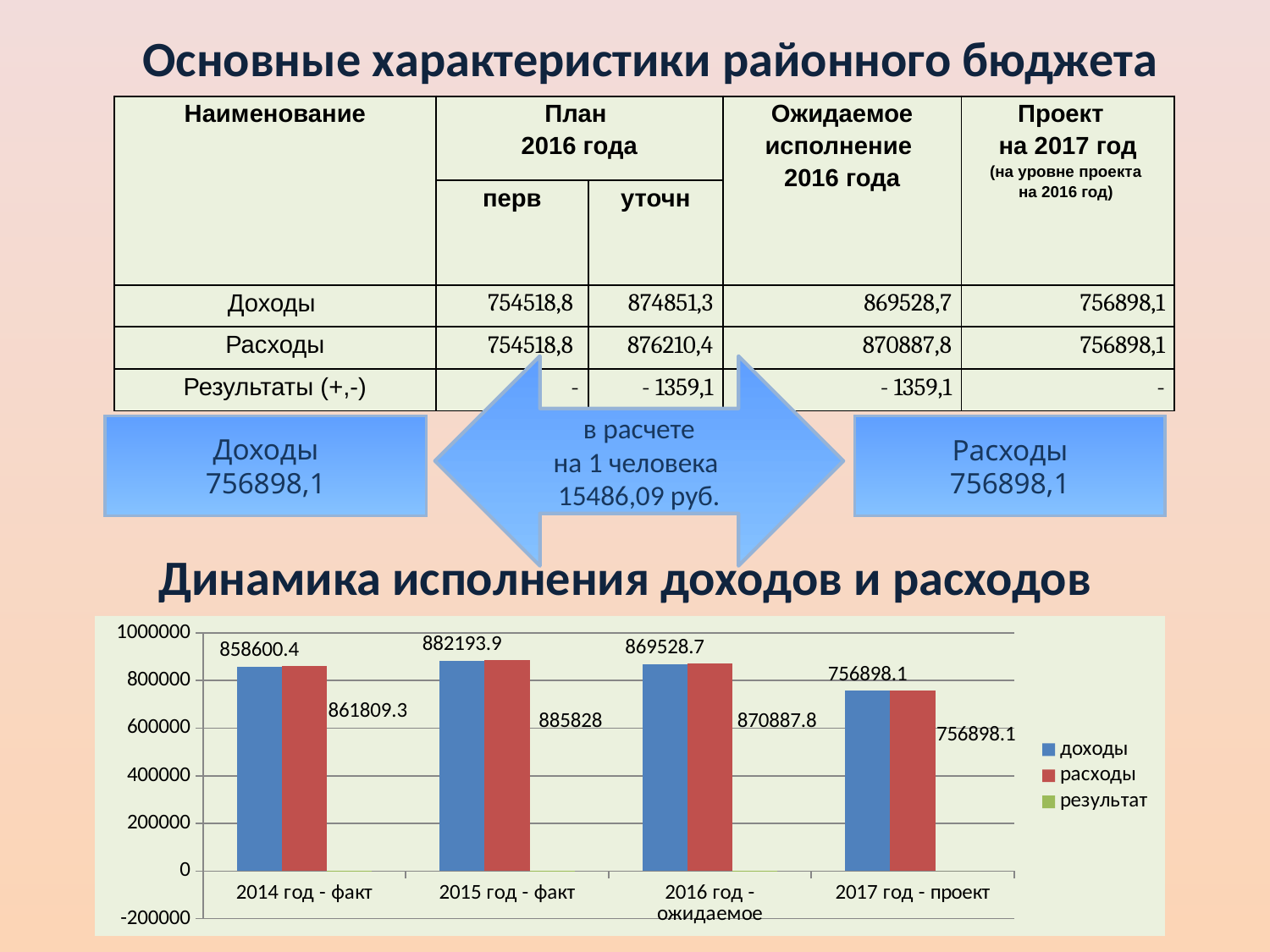
What is the value of расходы for 2017 год - проект? 756898.1 What is the difference between расходы and доходы for 2016 год - ожидаемое? 1359.1 What kind of chart is shown on the slide? bar chart How many series does the chart legend list? 3 Which is larger: доходы for 2015 год - факт or доходы for 2017 год - проект? 2015 год - факт What is the difference between расходы and доходы for 2014 год - факт? 3208.9 What is the value of доходы for 2014 год - факт? 858600.4 Which category has the lowest value of расходы? 2017 год - проект How many categories are shown on the x axis of the chart? 4 Which category has the highest value of доходы? 2015 год - факт What is the value of расходы for 2015 год - факт? 885828 What is the value of доходы for 2016 год - ожидаемое? 869528.7